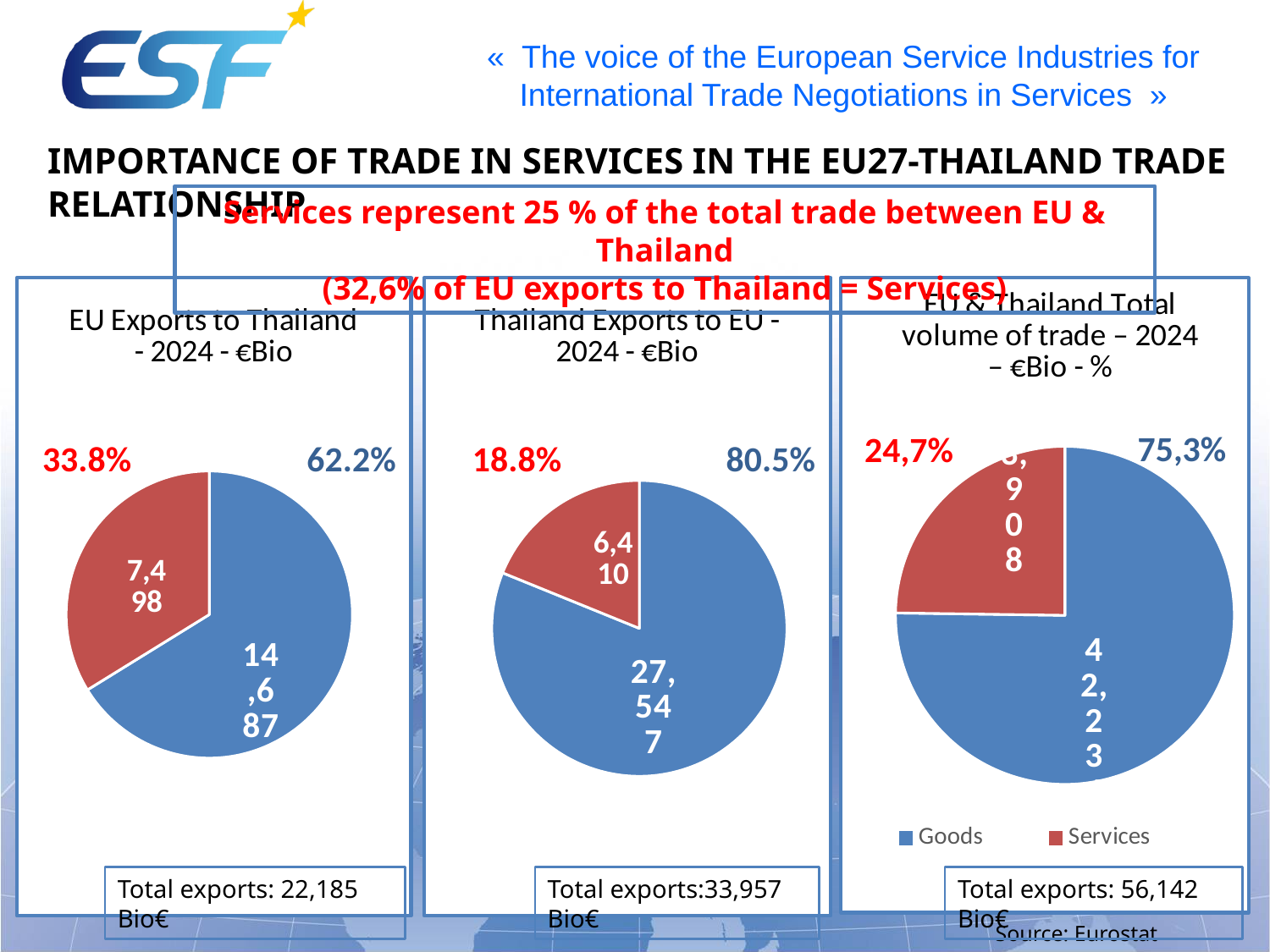
How many slices does the 'Thailand Exports to EU - 2024 - €Bio' pie chart have? 2 In the 'EU & Thailand Total volume of trade' chart, which category has the largest slice? Goods In the 'Thailand Exports to EU - 2024 - €Bio' chart, which slice is larger, Goods or Services? Goods In the 'EU Exports to Thailand - 2024 - €Bio' chart, what is the difference in percentage points between the Goods share and the Services share? 28.4 percentage points How many entries does the legend of the 'EU & Thailand Total volume of trade' chart list? 2 In the 'EU & Thailand Total volume of trade' chart, what percentage is shown for Goods? 75,3% In the 'Thailand Exports to EU - 2024 - €Bio' chart, what percentage is shown for the Goods (blue) slice? 80.5% In the 'EU Exports to Thailand - 2024 - €Bio' chart, what percentage is shown for the Goods (blue) slice? 62.2% In the 'EU & Thailand Total volume of trade' chart, what percentage is shown for Services? 24,7% In the 'EU Exports to Thailand - 2024 - €Bio' chart, what percentage is shown for the Services (red) slice? 33.8% What kind of chart is used for 'EU Exports to Thailand - 2024 - €Bio'? Pie chart In the 'Thailand Exports to EU - 2024 - €Bio' chart, what percentage is shown for the Services (red) slice? 18.8%